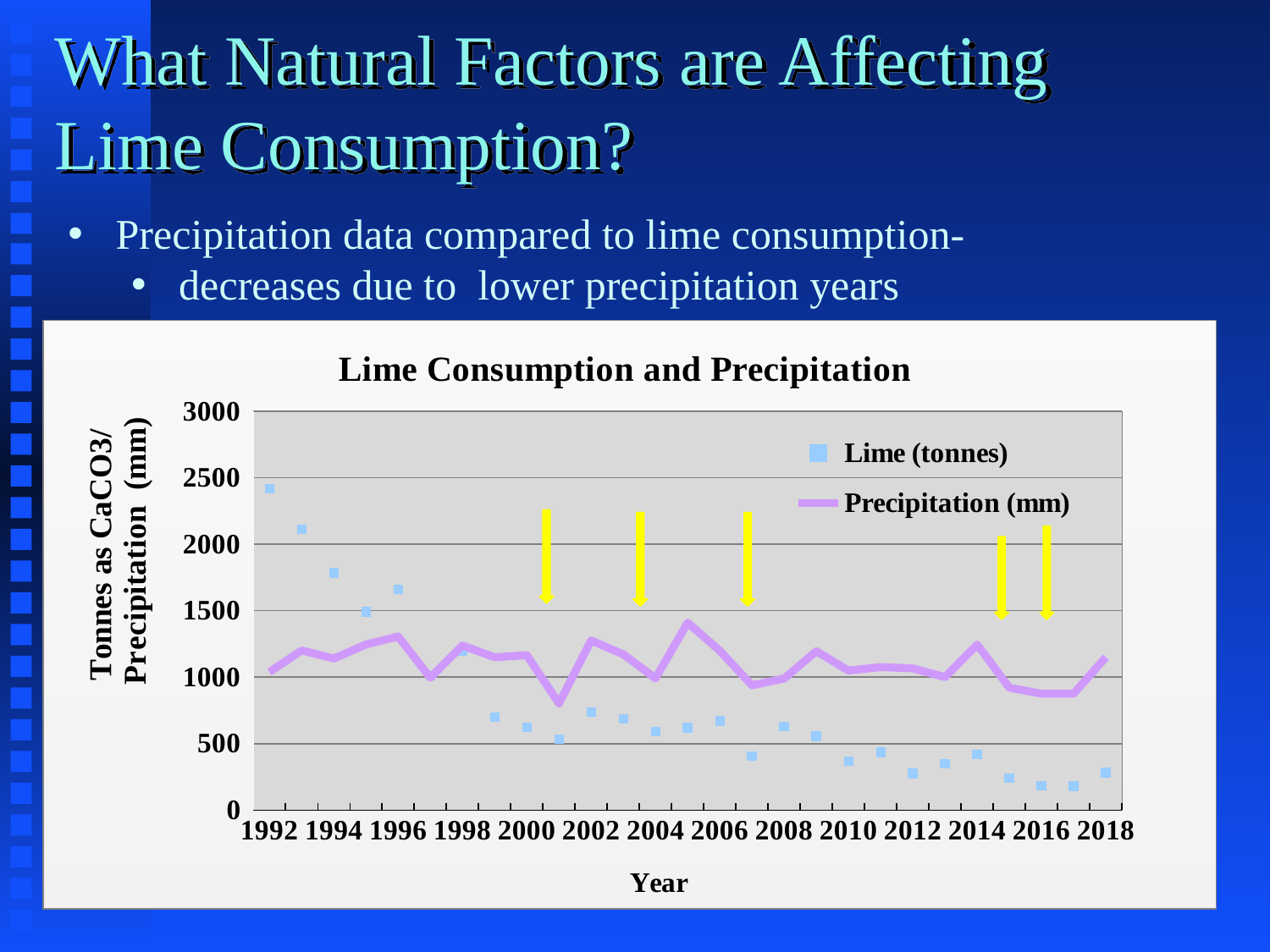
What is the title of the chart? Lime Consumption and Precipitation How many series does the chart legend list? 2 Is the Precipitation (mm) value for 2001 greater or less than 1000? less What are the two series named in the legend? Lime (tonnes) and Precipitation (mm) Which year has the highest Lime (tonnes) value? 1992 Which year has the highest Precipitation (mm) value? 2005 How many years are plotted along the x axis, from 1992 to 2018? 27 In 2018, which is larger: the Lime (tonnes) value or the Precipitation (mm) value? Precipitation (mm) Overall, do the Lime (tonnes) values rise or fall from 1992 to 2018? fall Is the Lime (tonnes) value for 1994 greater or less than 1500? greater Is the Lime (tonnes) value for 1992 greater or less than 2000? greater